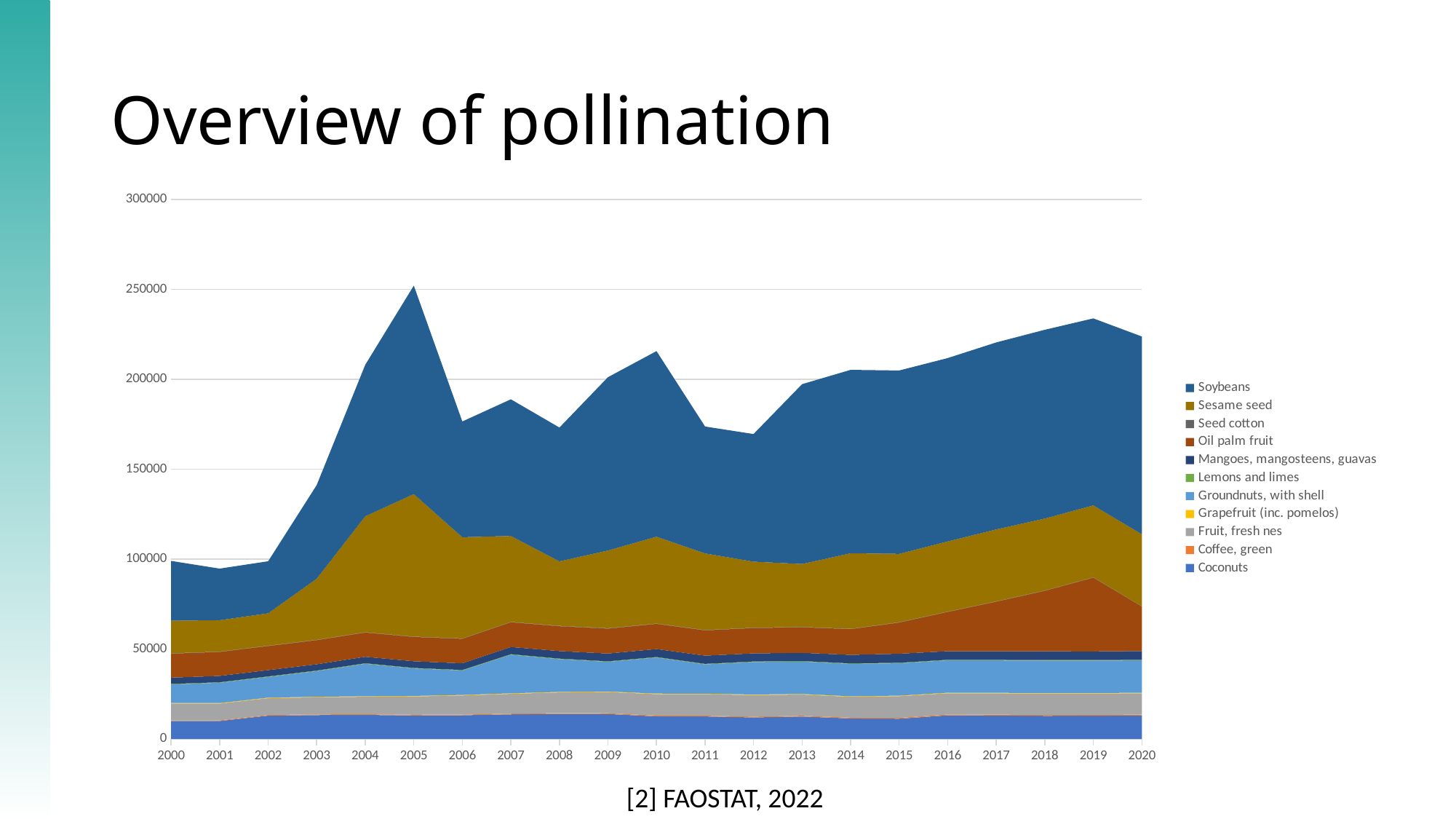
What kind of chart is shown on the slide? stacked area chart Which series is listed last in the legend? Coconuts How many series does the legend list? 11 Is the stacked total for 2001 greater or less than 100000? less Is the stacked total for 2005 greater or less than 200000? greater Which year has the larger stacked total, 2005 or 2010? 2005 Is the stacked total for 2019 greater or less than 200000? greater Which series is listed first in the legend? Soybeans Does the stacked total rise or fall from 2013 to 2019? rise How many years are shown along the x axis? 21 In which year does the stacked total reach its highest point? 2005